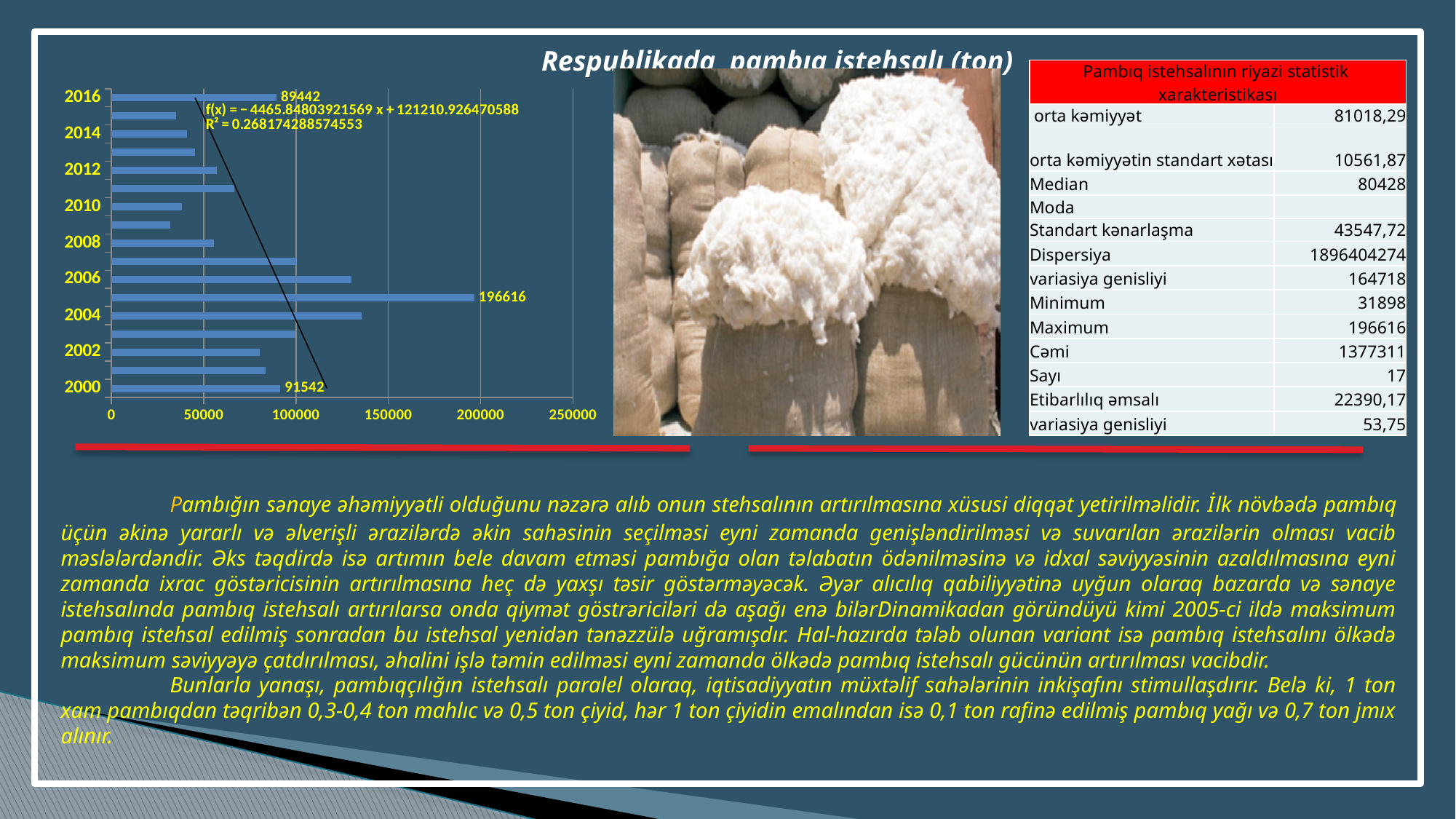
How many years (bars) are plotted in the chart? 17 What is the difference between the 2005 value and the 2000 value? 105074 What is the cotton production value for 2000 in the chart? 91542 What is the cotton production value for 2016 in the chart? 89442 What is the title of the chart? Respublikada pambıq istehsalı (ton) Is the value for 2009 greater or less than 50000? less Which year has the highest cotton production in the chart? 2005 Which year has the larger value, 2000 or 2016? 2000 Is the value for 2004 greater or less than 100000? greater What is the cotton production value for 2005 in the chart? 196616 What kind of chart is shown on the slide? bar chart What is the difference between the 2000 value and the 2016 value? 2100